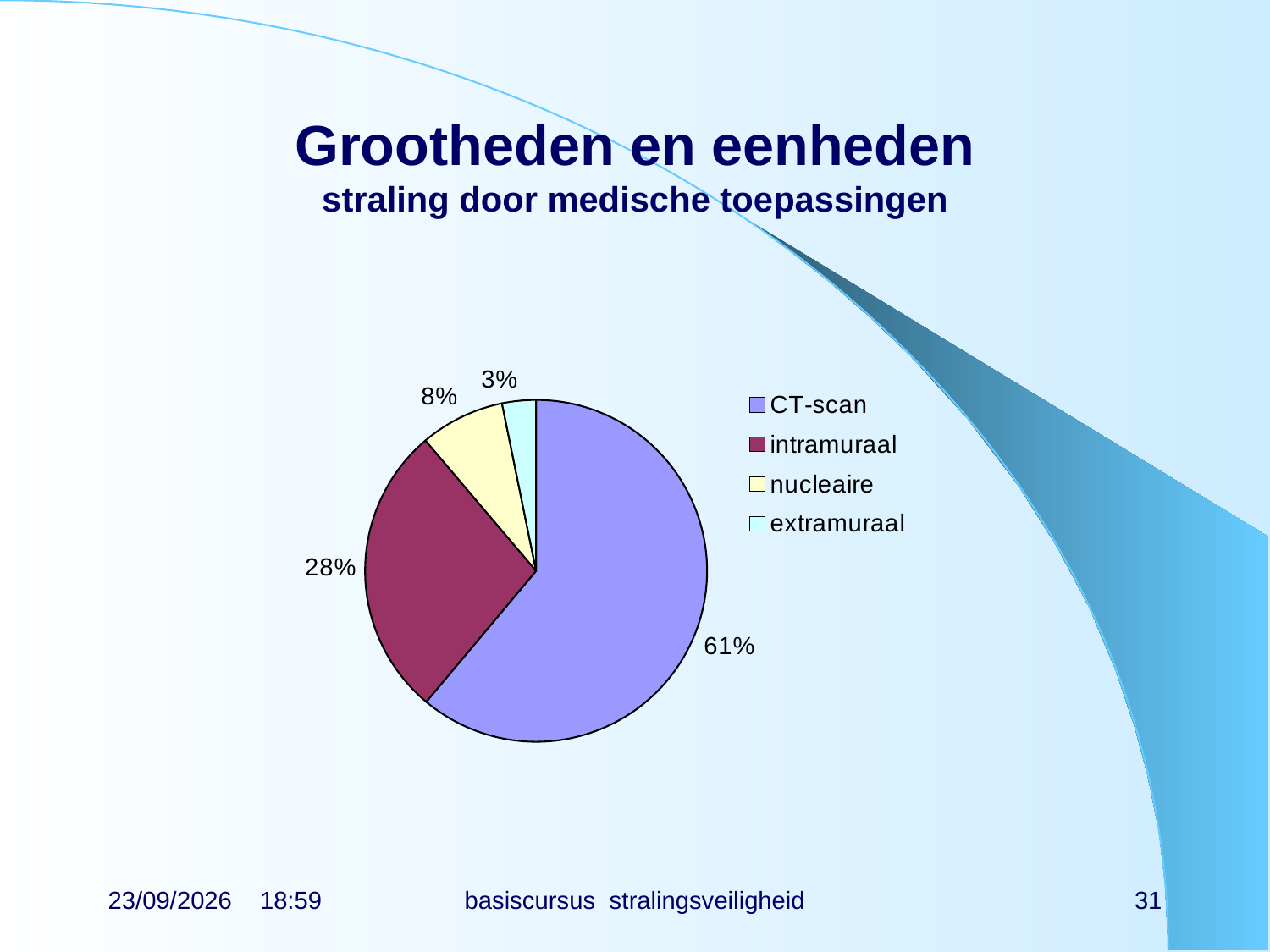
What is the difference in percentage points between CT-scan and intramuraal? 33 How many slices does the pie chart have? 4 Which category has the largest slice of the pie? CT-scan What is the combined share of nucleaire and extramuraal? 11% What type of chart is shown on the slide? pie chart What percentage is shown for intramuraal? 28% Which is larger, the share for nucleaire or the share for extramuraal? nucleaire Which legend entry is shown in dark red? intramuraal What percentage is shown for nucleaire? 8% What percentage is shown for extramuraal? 3% What share of the pie does CT-scan account for? 61% Which category has the smallest slice of the pie? extramuraal